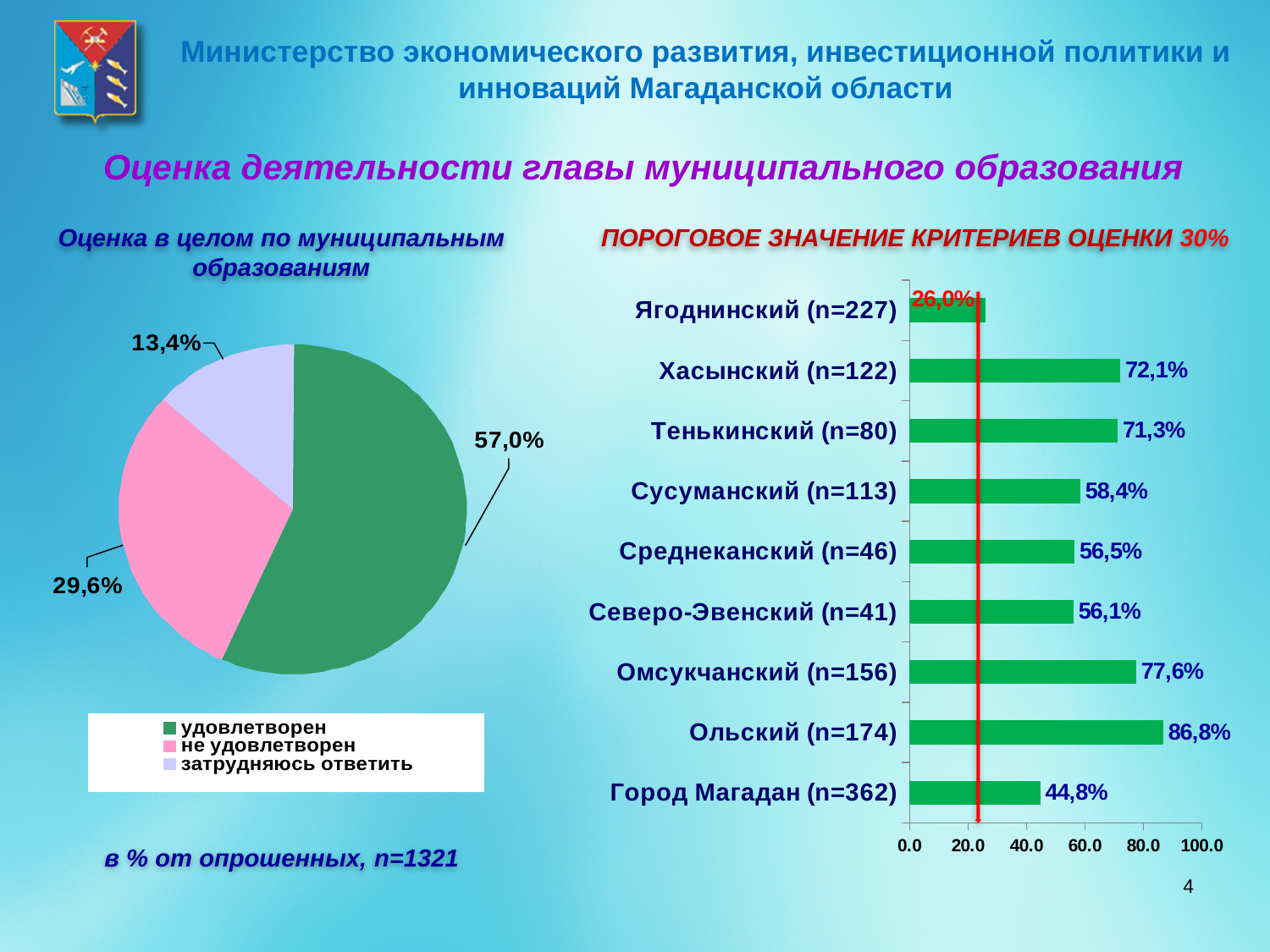
In the pie chart on the left, what share of respondents answered "затрудняюсь ответить"? 13,4% In the pie chart on the left, which response has the smallest slice? затрудняюсь ответить In the bar chart on the right, which is larger: the value for Хасынский (n=122) or Город Магадан (n=362)? Хасынский (n=122) In the bar chart on the right, which municipality has the lowest value? Ягоднинский (n=227) In the pie chart on the left, what share of respondents answered "удовлетворен"? 57,0% What type of chart is shown on the right side of the slide? bar chart In the bar chart on the right, what is the value for Город Магадан (n=362)? 44,8% In the pie chart on the left, how many entries does the legend list? 3 In the bar chart on the right, how many municipalities are shown? 9 In the bar chart on the right, which municipality has the highest value? Ольский (n=174) In the bar chart on the right, what is the difference between the values for Омсукчанский (n=156) and Сусуманский (n=113)? 19,2% In the bar chart on the right, what is the value for Ольский (n=174)? 86,8%